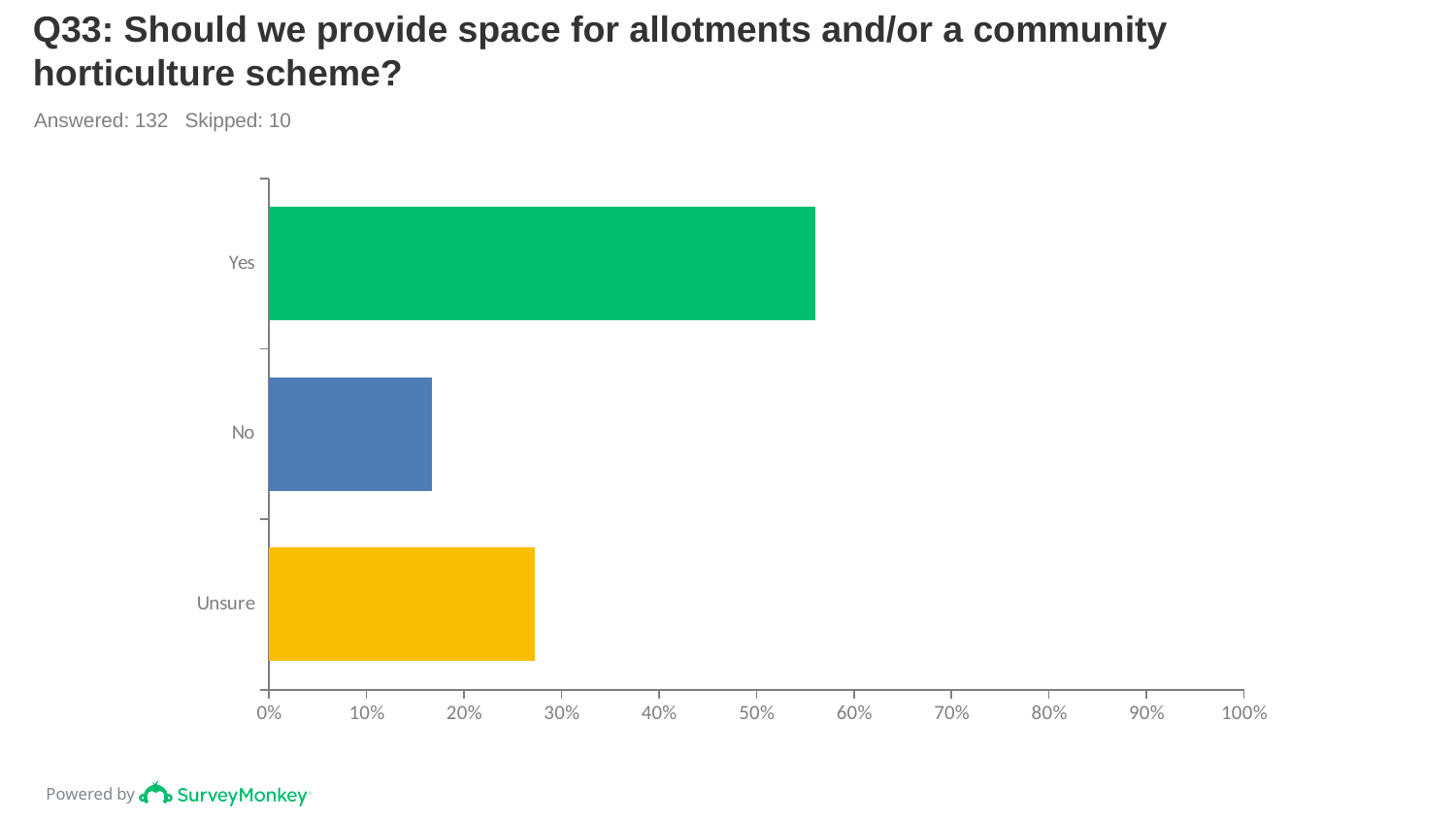
How many categories are shown in the chart? 3 Is the value for No greater or less than 20%? less Is the value for Unsure greater or less than 30%? less What colour is the bar for Unsure? Yellow Which category has the lowest value? No Is the value for Yes greater or less than 50%? greater How many respondents answered this question? 132 What kind of chart is shown on the slide? Bar chart Which is larger, the value for No or the value for Unsure? Unsure Which category has the highest value? Yes